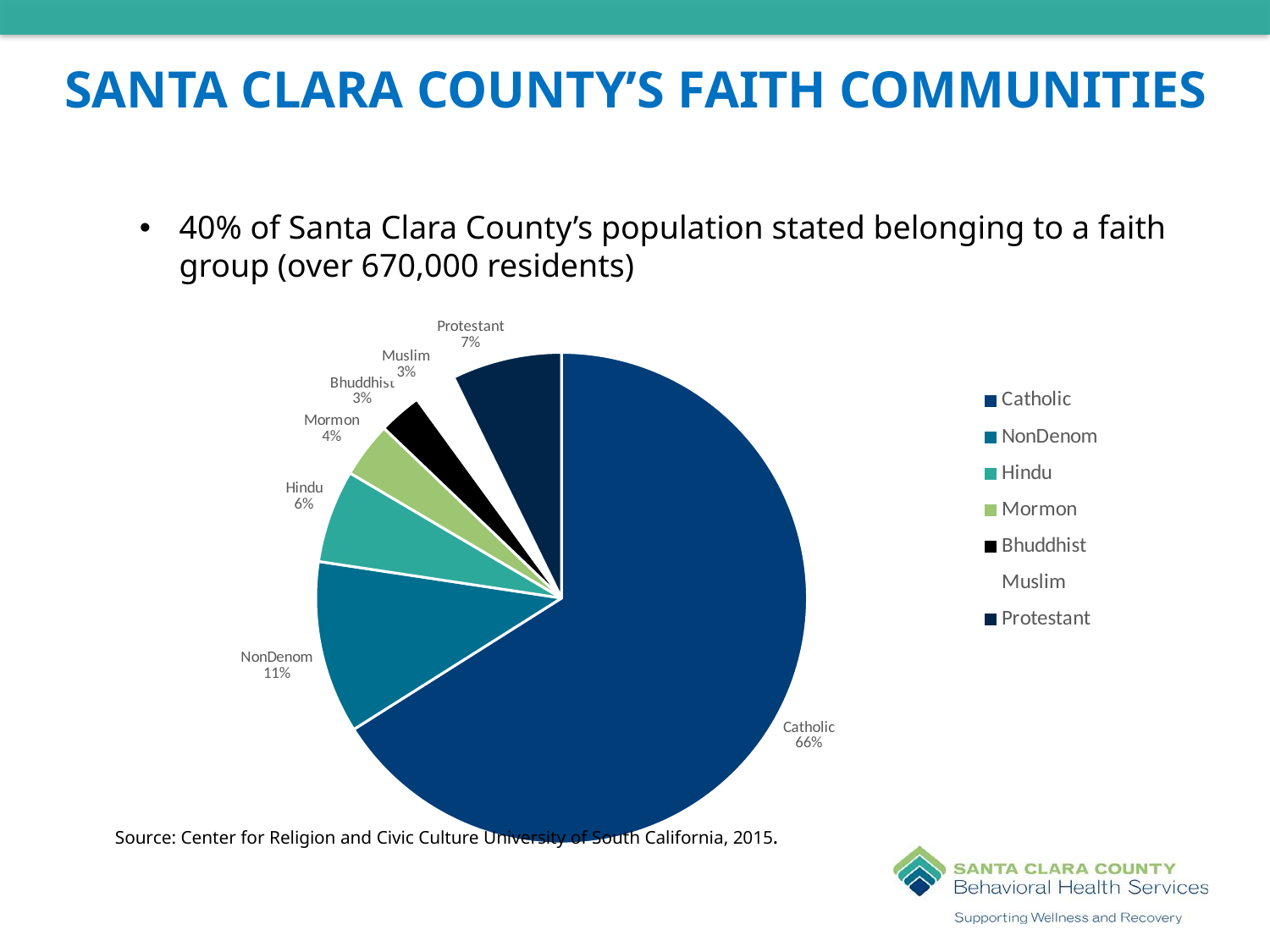
What is the value shown for NonDenom? 11% What is the difference between the Hindu and Mormon shares? 2% What kind of chart is shown on the slide? pie chart What is the value shown for Mormon? 4% What is the value shown for Protestant? 7% What is the value shown for Hindu? 6% Which is larger, the Protestant share or the Hindu share? Protestant What is the difference between the Catholic and NonDenom shares? 55% Which faith group has the largest slice of the pie? Catholic How many entries does the legend list? 7 What share of the pie does Catholic represent? 66% How many faith groups are shown in the pie chart? 7